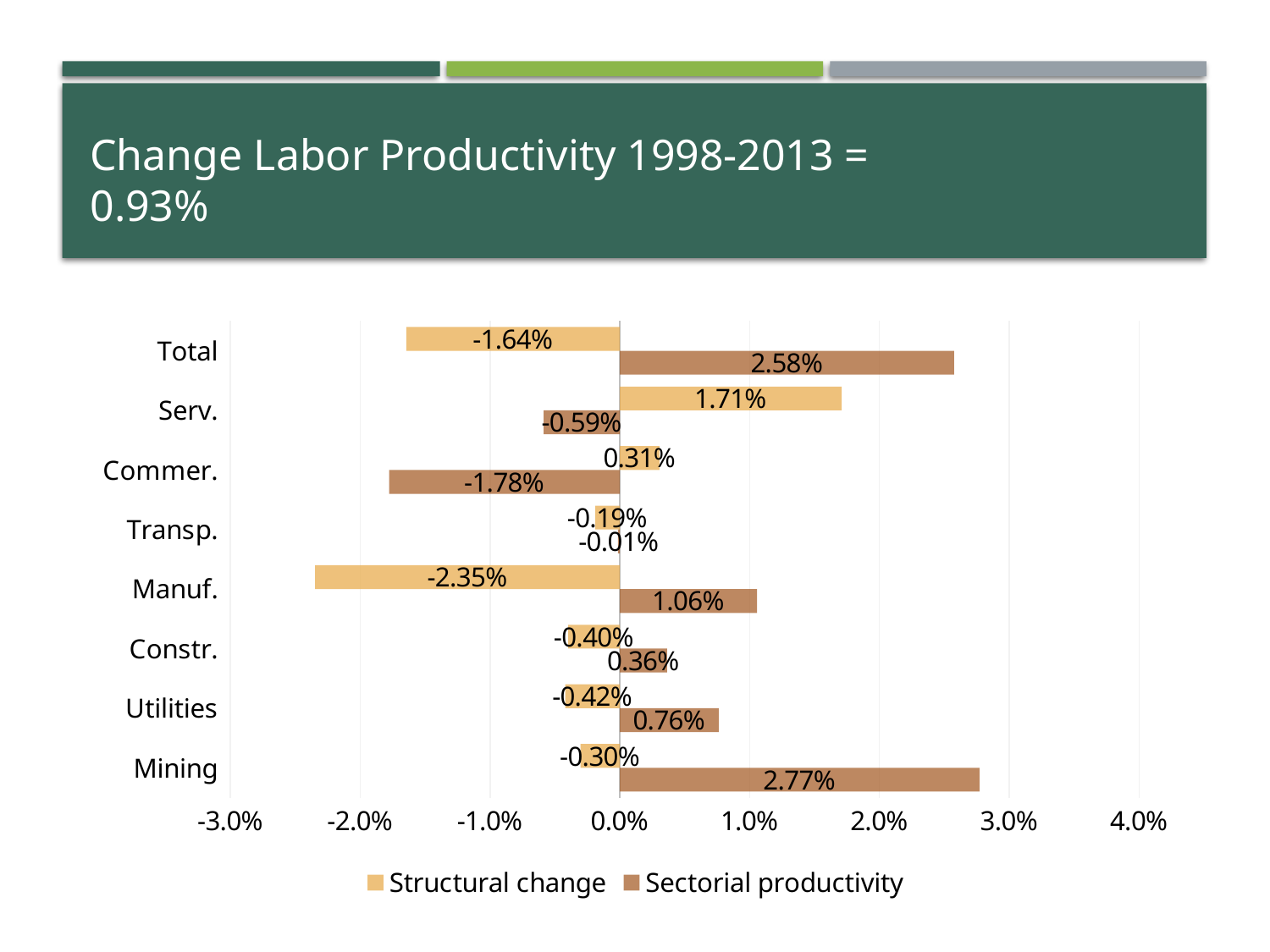
What is the Structural change value for Manuf.? -2.35% What is the Sectorial productivity value for Mining? 2.77% Which is larger: the Structural change value for Serv. or the Structural change value for Commer.? Serv. What is the Sectorial productivity value for Commer.? -1.78% How many series does the legend list? 2 Which category has the lowest Structural change value? Manuf. What is the difference between the Sectorial productivity and Structural change values for Total? 4.22 percentage points What kind of chart is shown on the slide? Bar chart What is the Structural change value for Serv.? 1.71% What are the two series named in the legend? Structural change and Sectorial productivity Which category has the highest Sectorial productivity value? Mining How many categories are shown on the chart? 8